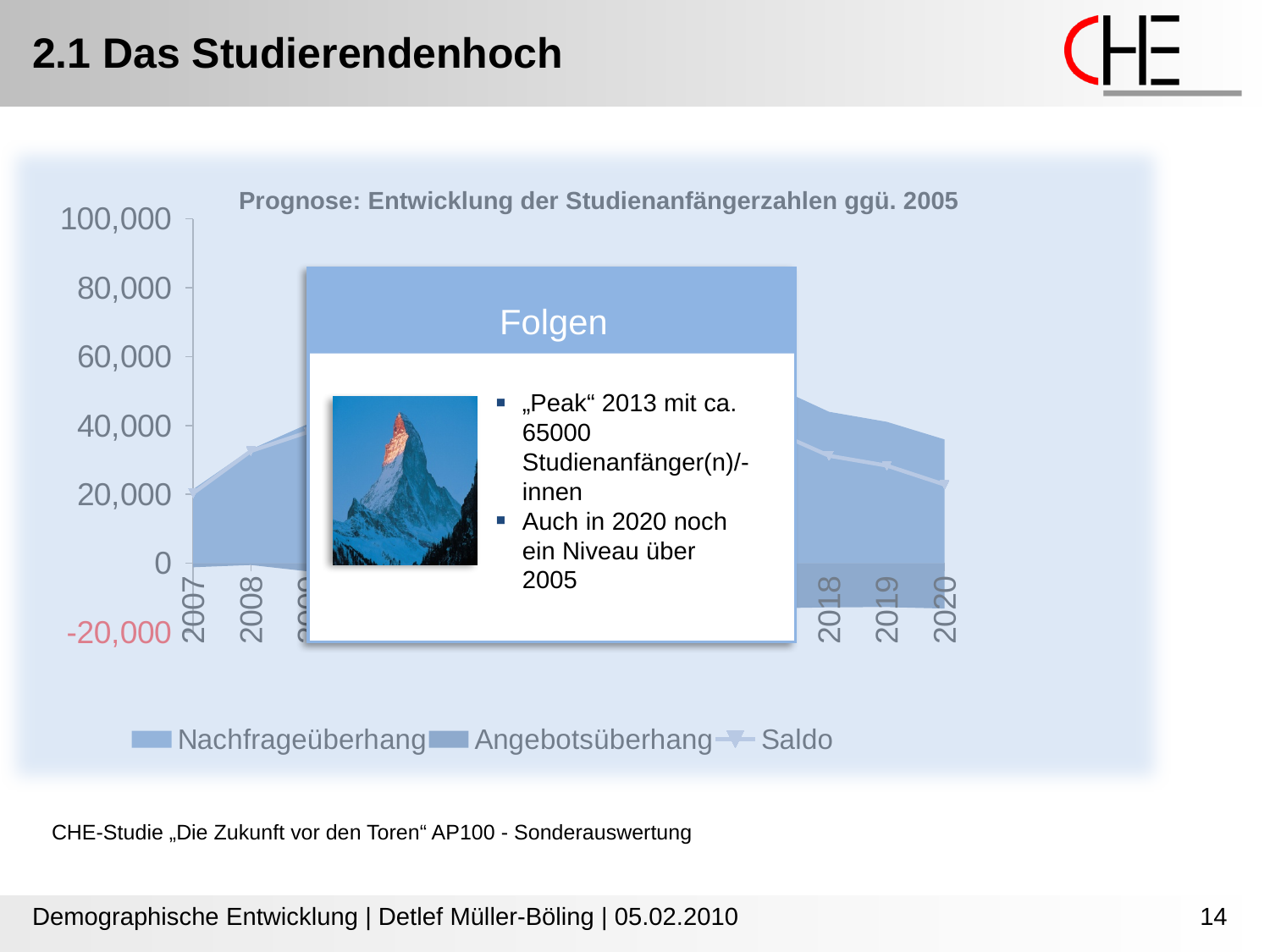
Does the Saldo line rise or fall from 2018 to 2020? fall What kind of chart is shown on the slide? combination area and line chart Which year has the larger Saldo value, 2007 or 2008? 2008 Is the Saldo value for 2008 greater or less than 20,000? greater What is the title of the chart? Prognose: Entwicklung der Studienanfängerzahlen ggü. 2005 Which year has the larger Saldo value, 2018 or 2020? 2018 Is the Saldo value for 2018 greater or less than 20,000? greater Does the Saldo line rise or fall from 2007 to 2008? rise What are the three series named in the chart legend? Nachfrageüberhang, Angebotsüberhang, Saldo Is the Saldo value for 2007 greater or less than 40,000? less How many series does the chart legend list? 3